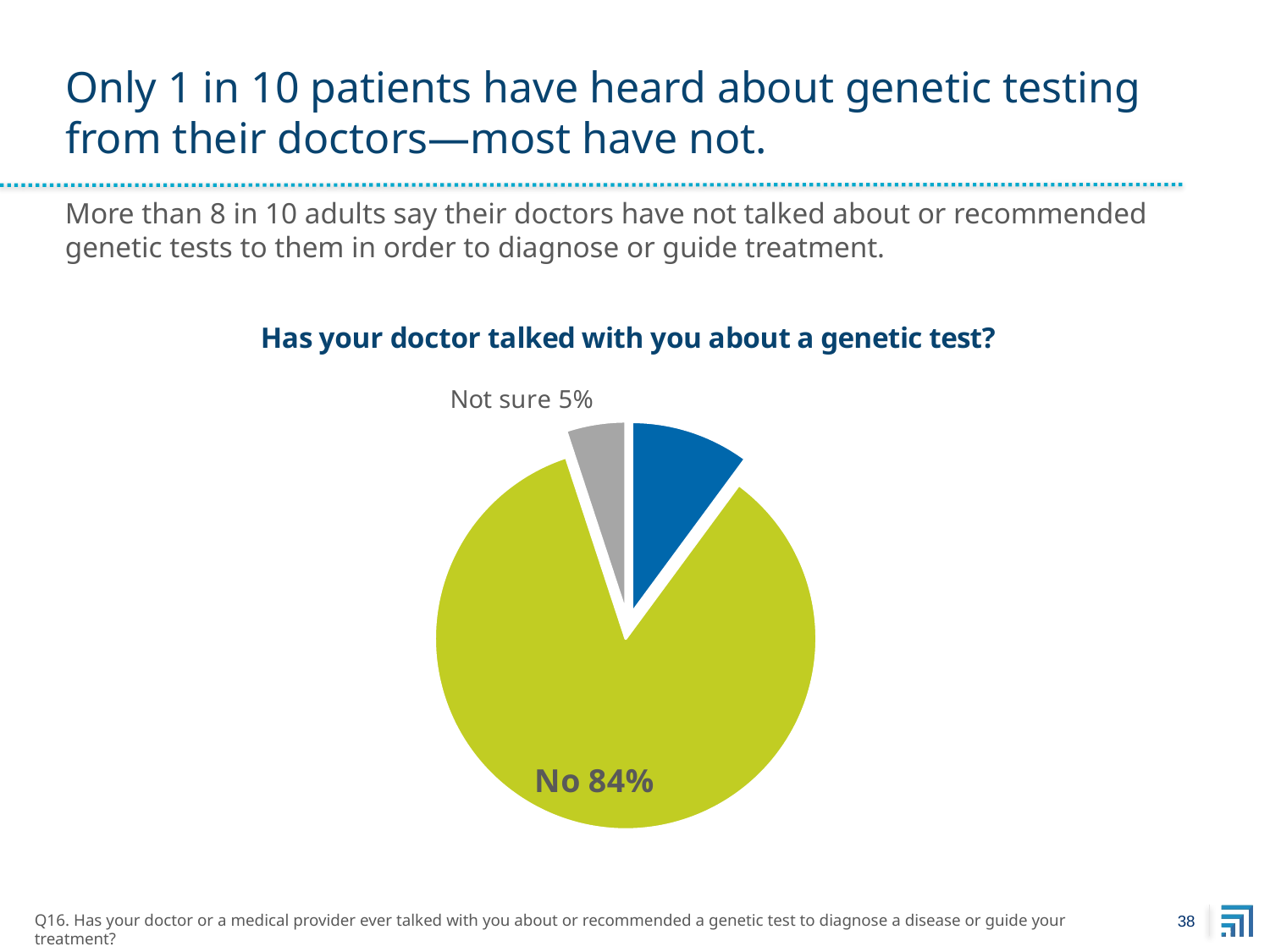
What share of the pie does the "No" slice represent? 84% What colour is the "No" slice of the pie? green Which response has the largest slice of the pie? No Which labelled response has the smallest slice of the pie? Not sure What is the title of the chart? Has your doctor talked with you about a genetic test? What is the difference in percentage points between the "No" and "Not sure" responses? 79 What kind of chart is shown on the slide? pie chart Which is larger, the "No" slice or the "Not sure" slice? No What percentage of respondents answered "Not sure"? 5% How many slices does the pie chart have? 3 What percentage of respondents answered "No"? 84%